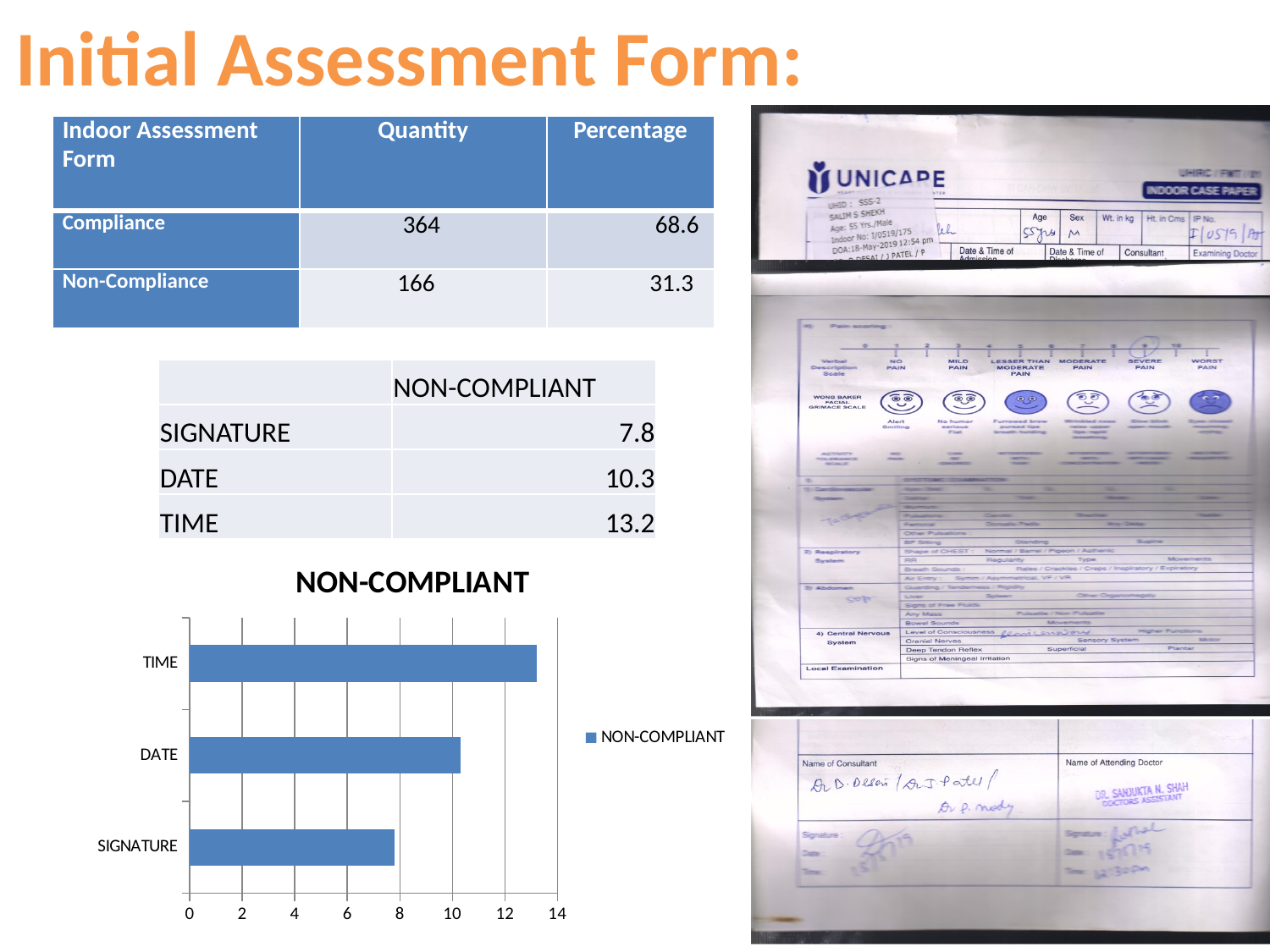
What kind of chart is shown on the slide? bar chart What is the value for SIGNATURE in the NON-COMPLIANT data shown on the slide? 7.8 In the NON-COMPLIANT bar chart, which is larger, the value for DATE or the value for SIGNATURE? DATE In the NON-COMPLIANT bar chart, is the value for TIME greater or less than 12? greater What is the value for TIME in the NON-COMPLIANT data shown on the slide? 13.2 Which category has the highest value in the NON-COMPLIANT bar chart? TIME How many categories are plotted in the NON-COMPLIANT bar chart? 3 Which category has the lowest value in the NON-COMPLIANT bar chart? SIGNATURE In the NON-COMPLIANT bar chart, is the value for DATE greater or less than 12? less What is the title of the bar chart on the slide? NON-COMPLIANT How many series does the legend of the NON-COMPLIANT chart list? 1